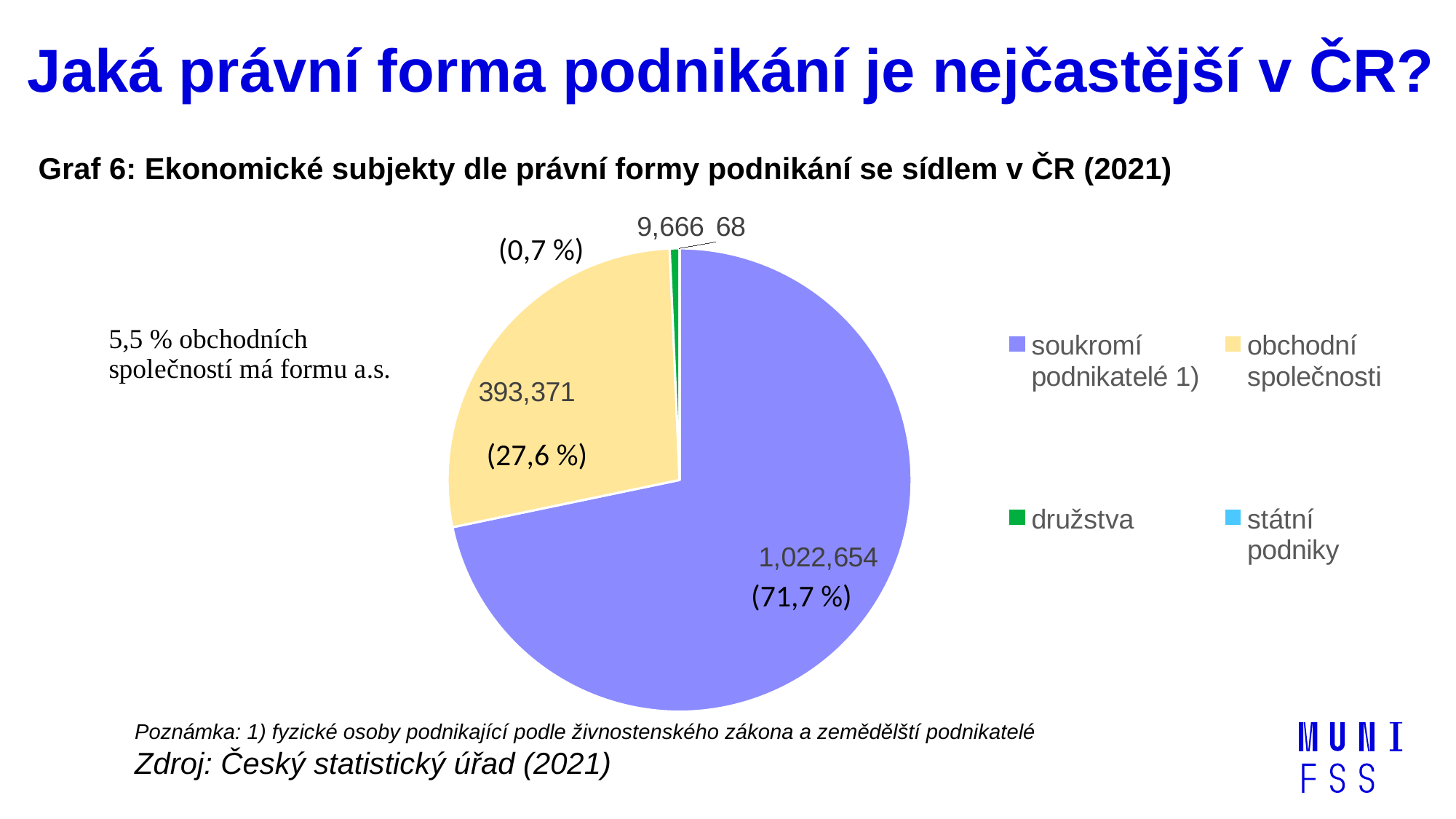
What is the value for soukromí podnikatelé? 1,022,654 What is the value for státní podniky? 68 What is the difference between the values for soukromí podnikatelé and obchodní společnosti? 629,283 How many categories does the pie chart show? 4 What is the value for družstva? 9,666 What kind of chart is shown on the slide? pie chart Which category has the largest slice of the pie? soukromí podnikatelé Which category has the smallest slice of the pie? státní podniky How many entries does the legend list? 4 What is the value for obchodní společnosti? 393,371 What is the title of the chart? Graf 6: Ekonomické subjekty dle právní formy podnikání se sídlem v ČR (2021) What share of the pie do obchodní společnosti represent? 27,6 %